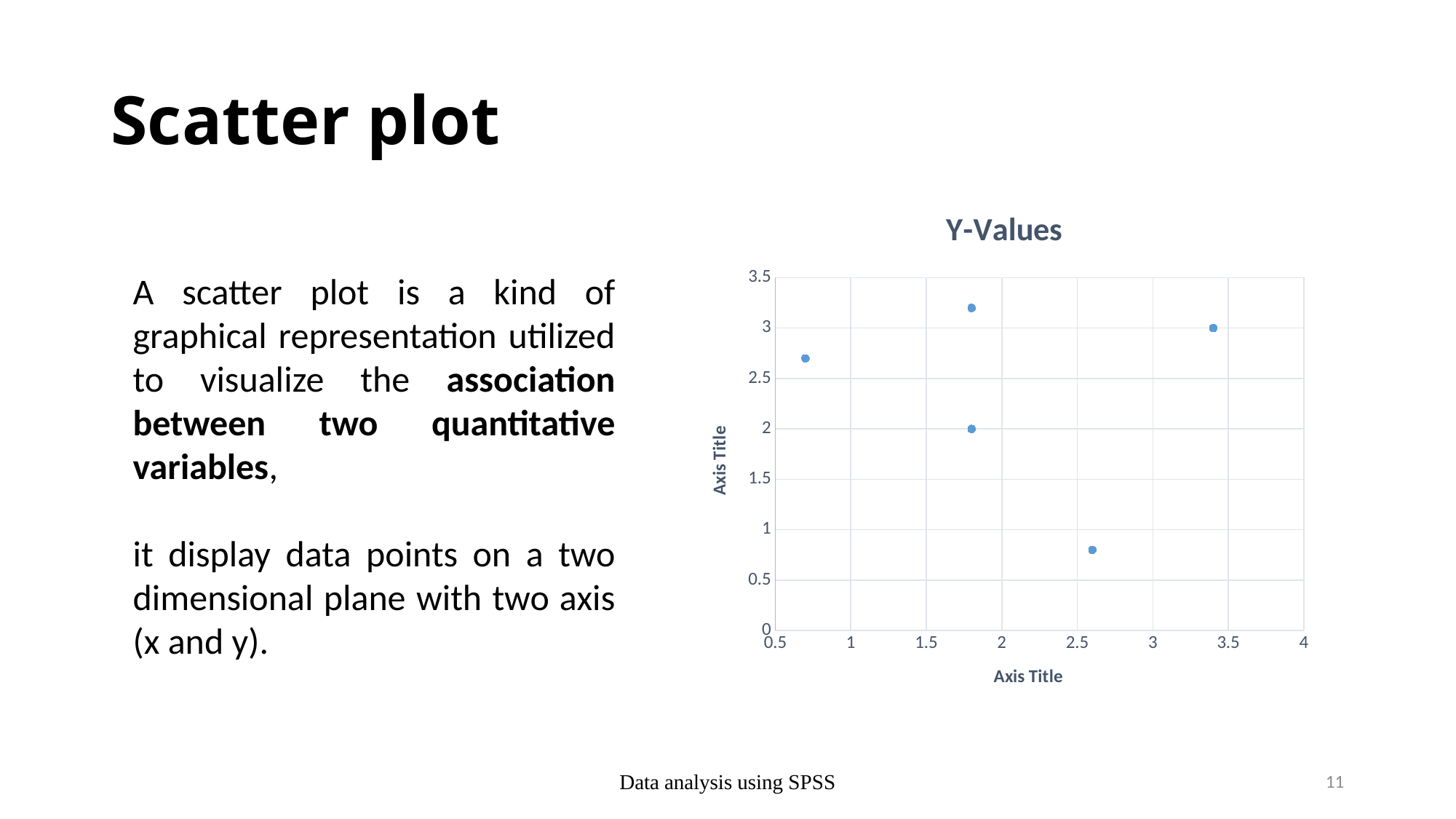
How many points in the chart have a y-value greater than 2.5? 3 What is the title of the chart? Y-Values Is the y-value of the rightmost point (between x = 3 and x = 3.5) greater or less than 2.5? greater What is the label shown on the horizontal axis of the chart? Axis Title What kind of chart is shown on the slide? Scatter plot Is the y-value of the leftmost point (near x = 0.5–1) greater or less than 2.5? greater How many points in the chart have a y-value less than 1? 1 Is the y-value of the lowest point in the chart greater or less than 1? less How many data points are plotted in the chart? 5 Is the highest point in the chart located to the left or to the right of x = 2? left